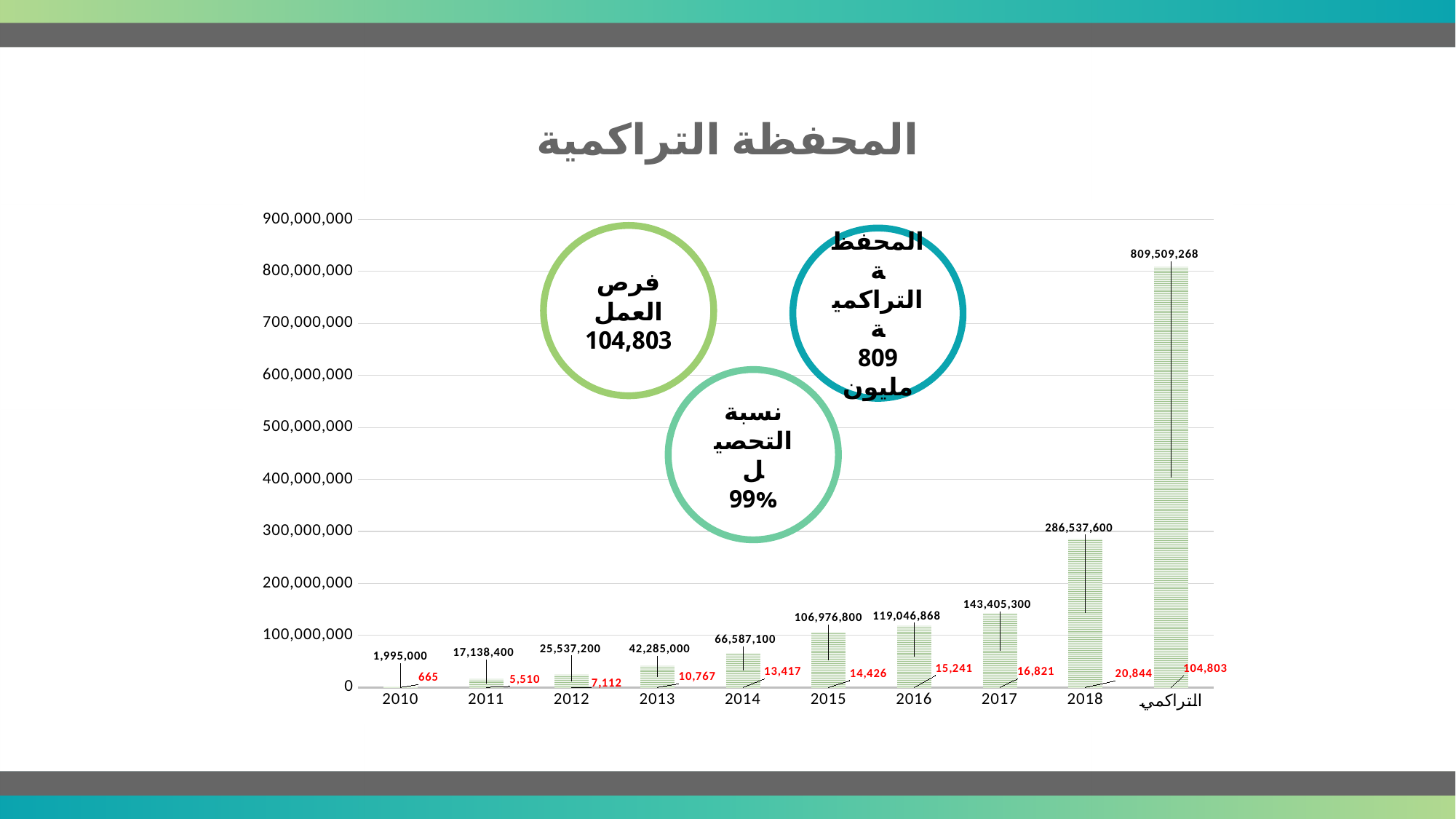
Which is larger, the portfolio value for 2013 or for 2012? 2013 Do the portfolio values rise or fall from 2010 to 2018? Rise What kind of chart is shown on the slide? Bar chart Which year from 2010 to 2018 has the highest portfolio value? 2018 What is the difference between the red values for 2018 and 2017? 4,023 What is the portfolio value labelled on the bar for 2014? 66,587,100 What is the portfolio value labelled on the bar for 2018? 286,537,600 What is the difference between the portfolio values for 2018 and 2017? 143,132,300 What is the red value shown for 2015? 14,426 How many categories are shown on the x axis? 10 What is the value labelled on the bar for التراكمي (cumulative)? 809,509,268 Which year from 2010 to 2018 has the lowest portfolio value? 2010